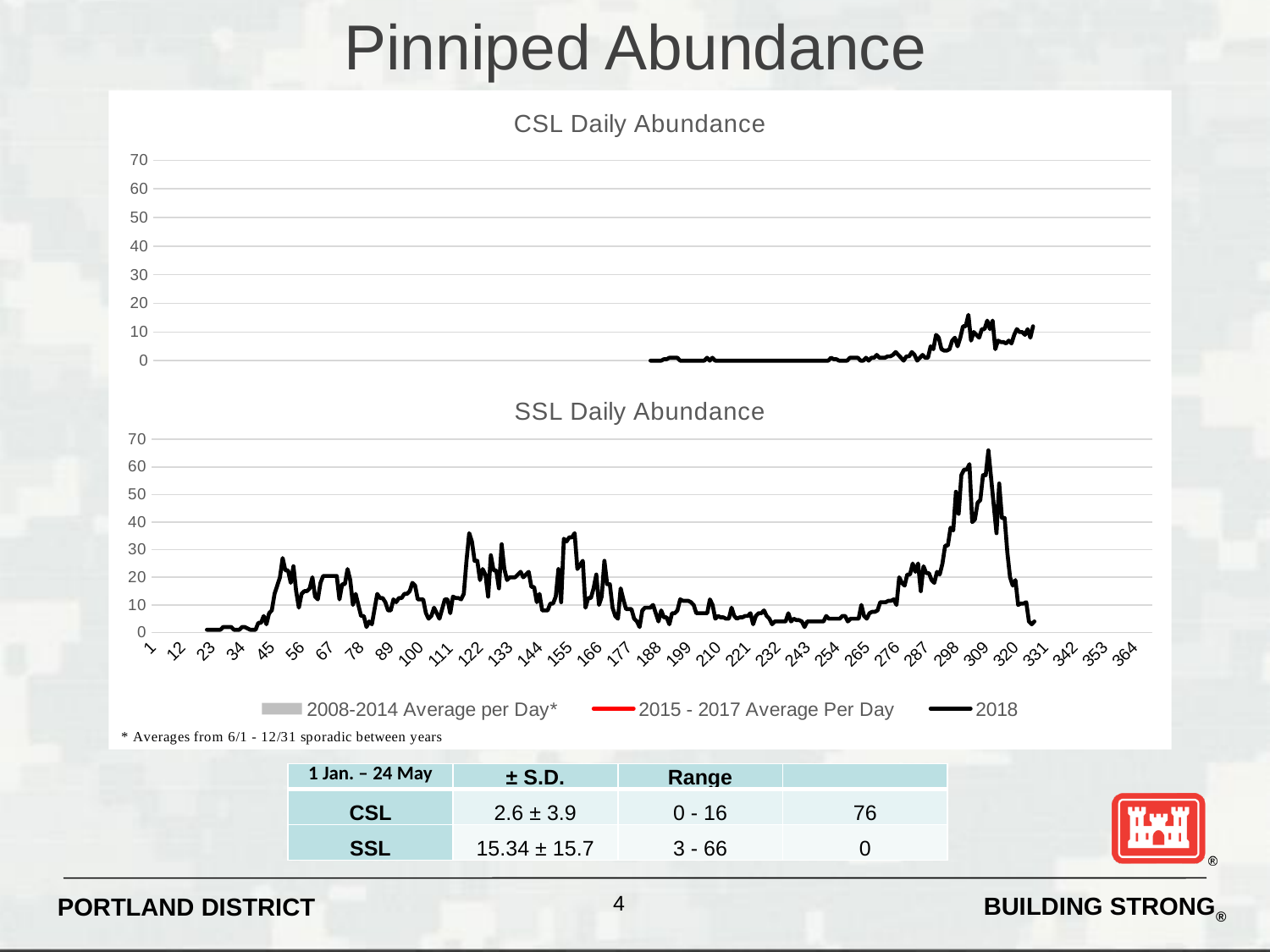
What is the highest value shown on the y axis of the SSL Daily Abundance chart? 70 What is the title of the upper chart on the slide? CSL Daily Abundance In the SSL Daily Abundance chart, is the 2018 value at day 232 greater or less than 20? less What kind of chart is the CSL Daily Abundance chart? line chart In the SSL Daily Abundance chart, does the 2018 line rise or fall between day 309 and day 331? fall Which chart's 2018 line reaches a higher peak, CSL Daily Abundance or SSL Daily Abundance? SSL Daily Abundance What kind of chart is the SSL Daily Abundance chart? line chart In the legend, which series is drawn with a black line? 2018 In the CSL Daily Abundance chart, is the highest value of the 2018 line greater or less than 20? less How many series does the legend list for the charts? 3 In the SSL Daily Abundance chart, is the highest value of the 2018 line greater or less than 60? greater In the CSL Daily Abundance chart, does the 2018 line generally rise or fall from day 265 to day 320? rise